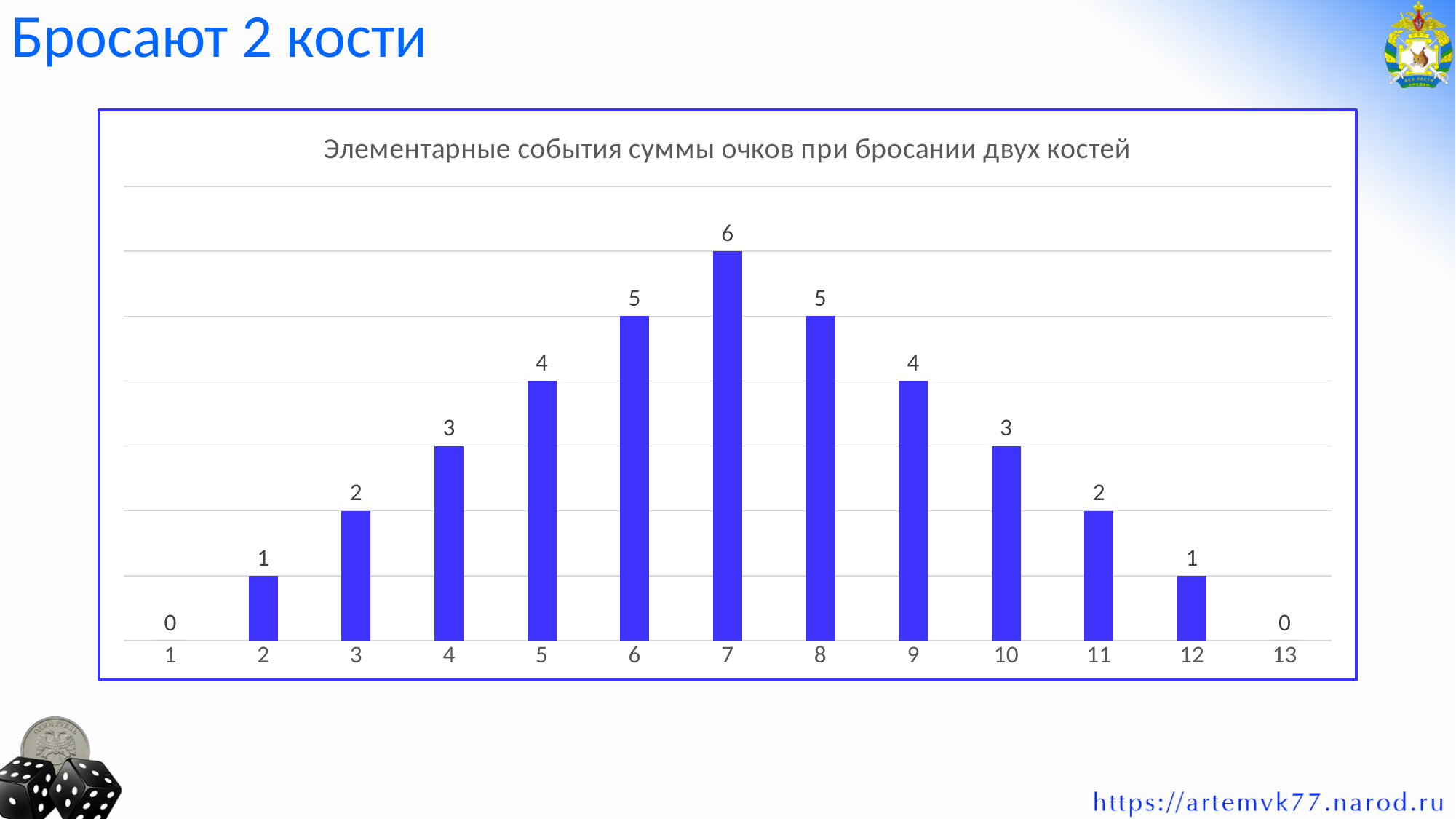
What kind of chart is this? Bar chart Which category has the highest value? 7 Which is larger, the value for category 3 or the value for category 8? Category 8 What is the value for category 4? 3 What is the title of the chart? Элементарные события суммы очков при бросании двух костей Do the values rise or fall from category 1 to category 7? Rise Which is larger, the value for category 5 or the value for category 9? They are equal (4) How many categories are shown on the x axis? 13 What is the value for category 11? 2 What is the value for category 7? 6 What is the difference between the values for category 7 and category 2? 5 What is the difference between the values for category 6 and category 10? 2